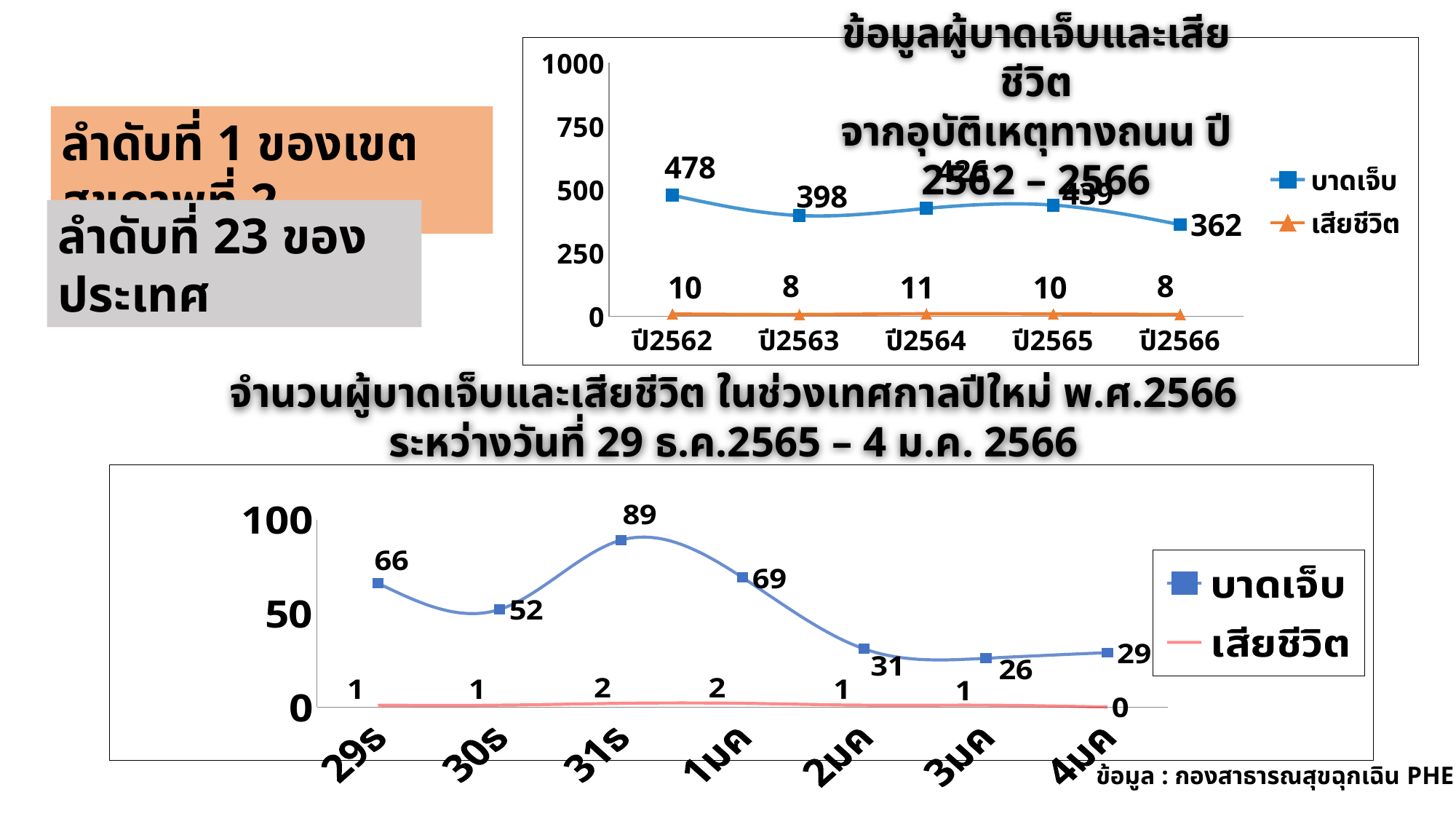
In the bottom chart, which is larger: the บาดเจ็บ value for 29ธ or for 1มค? 1มค In the bottom chart, what is the บาดเจ็บ value for 31ธ? 89 In the top chart, what is the value for เสียชีวิต in ปี2564? 11 In the bottom chart, what is the เสียชีวิต value for 4มค? 0 In the top chart, is the บาดเจ็บ value for ปี2565 greater or less than 250? greater In the bottom chart, which day has the highest บาดเจ็บ value? 31ธ What type of chart is the bottom chart? line chart In the top chart, what is the difference between the บาดเจ็บ values for ปี2562 and ปี2566? 116 In the bottom chart, how many days are plotted on the x axis? 7 In the top chart, how many series does the legend list? 2 In the top chart, what is the value for บาดเจ็บ in ปี2562? 478 In the top chart, which year has the lowest บาดเจ็บ value? ปี2566